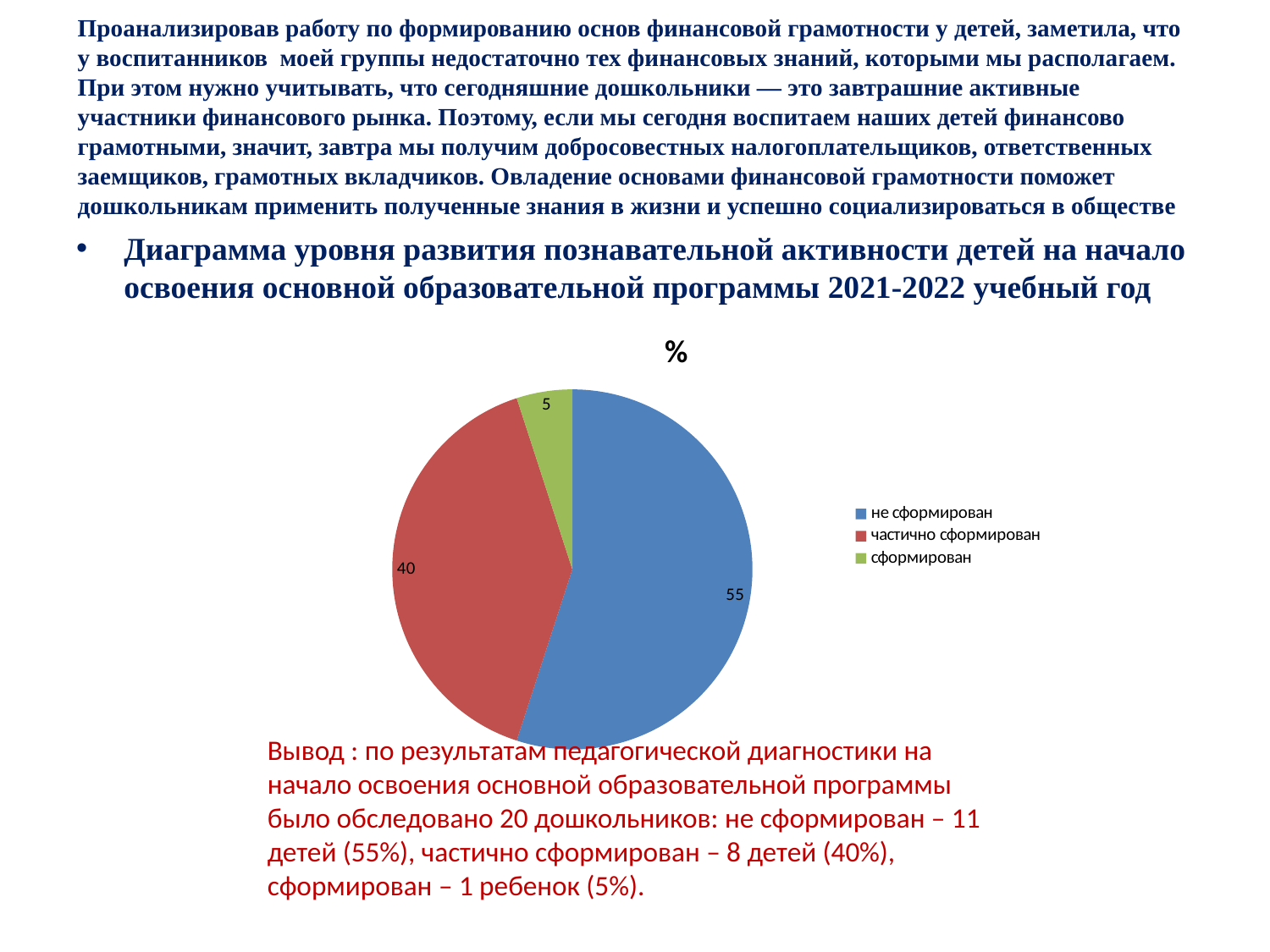
What kind of chart is shown on the slide? pie chart What is the difference between the values for 'частично сформирован' and 'сформирован'? 35 What is the value for the 'частично сформирован' slice? 40 Which is larger, the value for 'частично сформирован' or the value for 'сформирован'? частично сформирован What is the difference between the values for 'не сформирован' and 'частично сформирован'? 15 What colour is the 'сформирован' slice? green Which category has the largest slice? не сформирован What is the value for the 'сформирован' slice? 5 How many categories does the pie chart have? 3 What is the value for the 'не сформирован' slice? 55 Which category has the smallest slice? сформирован What is the title of the chart? %